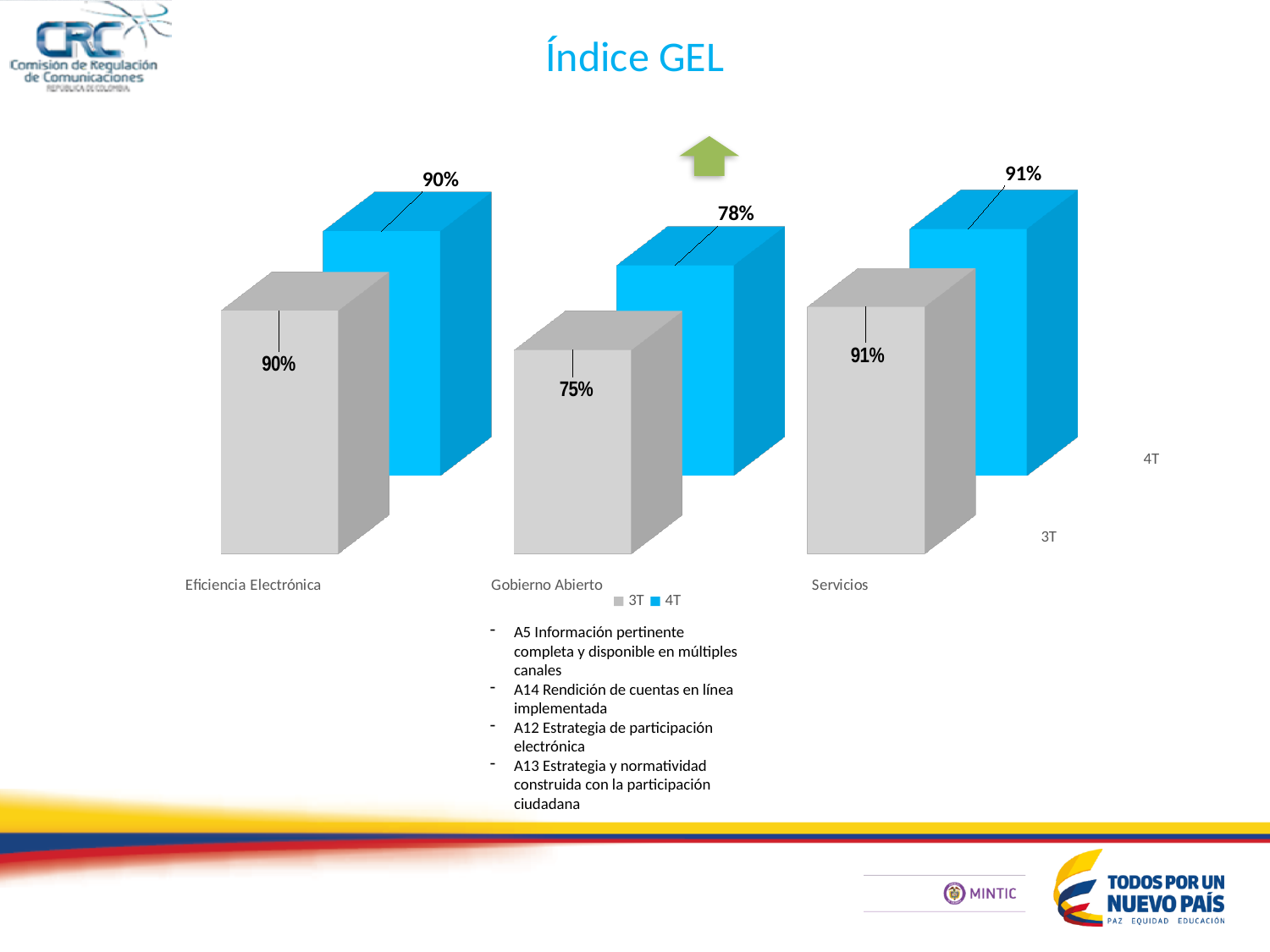
What is the 3T value for Gobierno Abierto? 75% Which is larger for Gobierno Abierto, the 3T value or the 4T value? 4T What kind of chart is shown on the slide? bar chart What is the 4T value for Gobierno Abierto? 78% Which category has the highest 3T value? Servicios How many categories are shown on the x axis? 3 What is the 3T value for Servicios? 91% What is the 4T value for Eficiencia Electrónica? 90% Which category has the lowest 4T value? Gobierno Abierto What is the title of the chart? Índice GEL What is the difference between the 4T and 3T values for Gobierno Abierto? 3% How many series does the legend list? 2